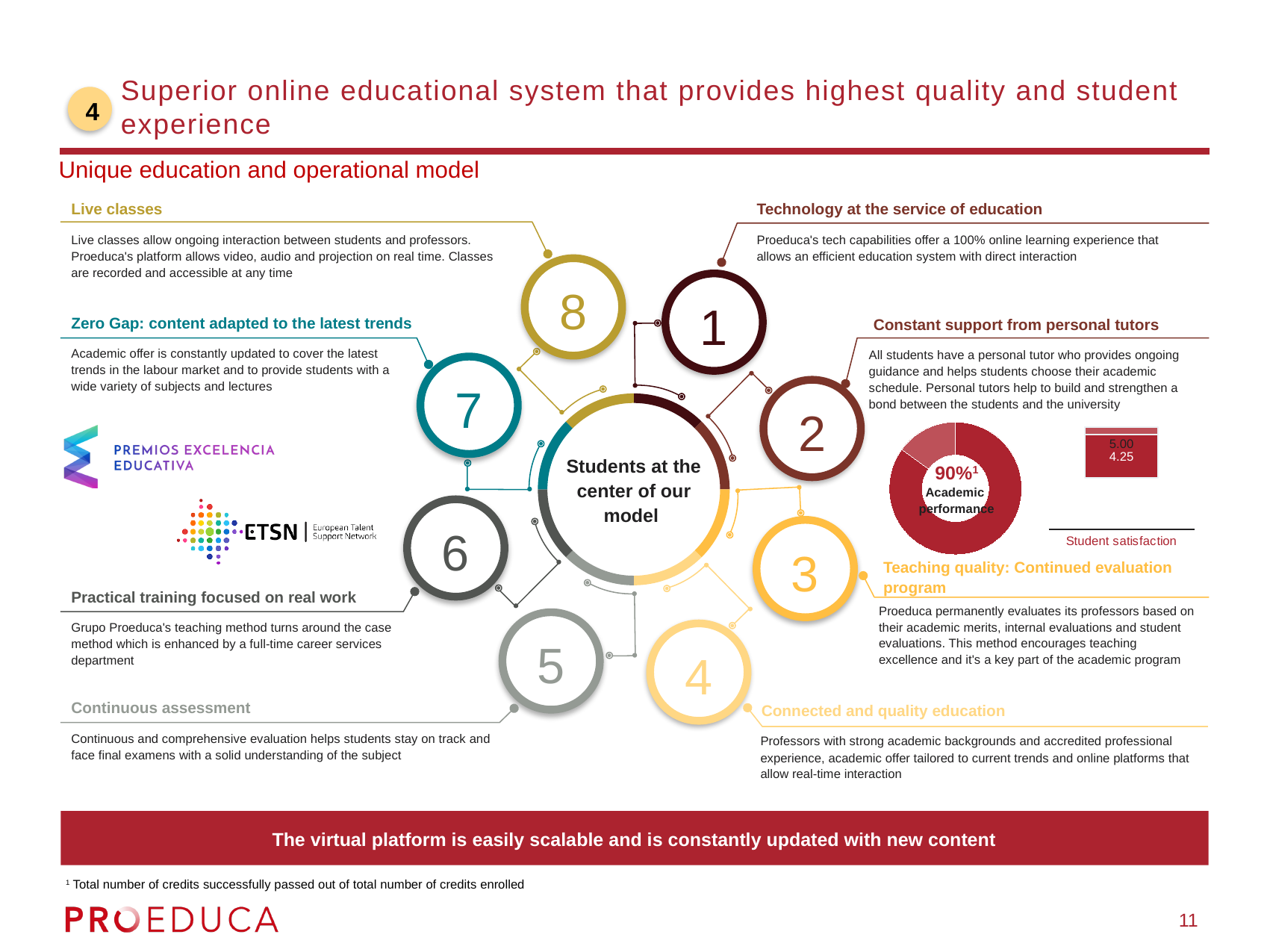
What share of the academic performance pie chart is not covered by the 90% slice? 10% What is the difference between the maximum value 5.00 and the student satisfaction value in the bar chart? 0.75 What is the maximum value shown on the student satisfaction bar chart? 5.00 What academic performance value is shown in the pie chart? 90% What kind of chart is used to show student satisfaction? bar chart According to footnote 1, how is academic performance in the pie chart defined? Total number of credits successfully passed out of total number of credits enrolled What is the label printed inside the academic performance pie chart below the percentage? Academic performance What kind of chart is used to show academic performance? doughnut chart What is the student satisfaction value shown in the bar chart? 4.25 How many bars are plotted in the student satisfaction chart? 1 Is the student satisfaction value greater or less than 5.00? less